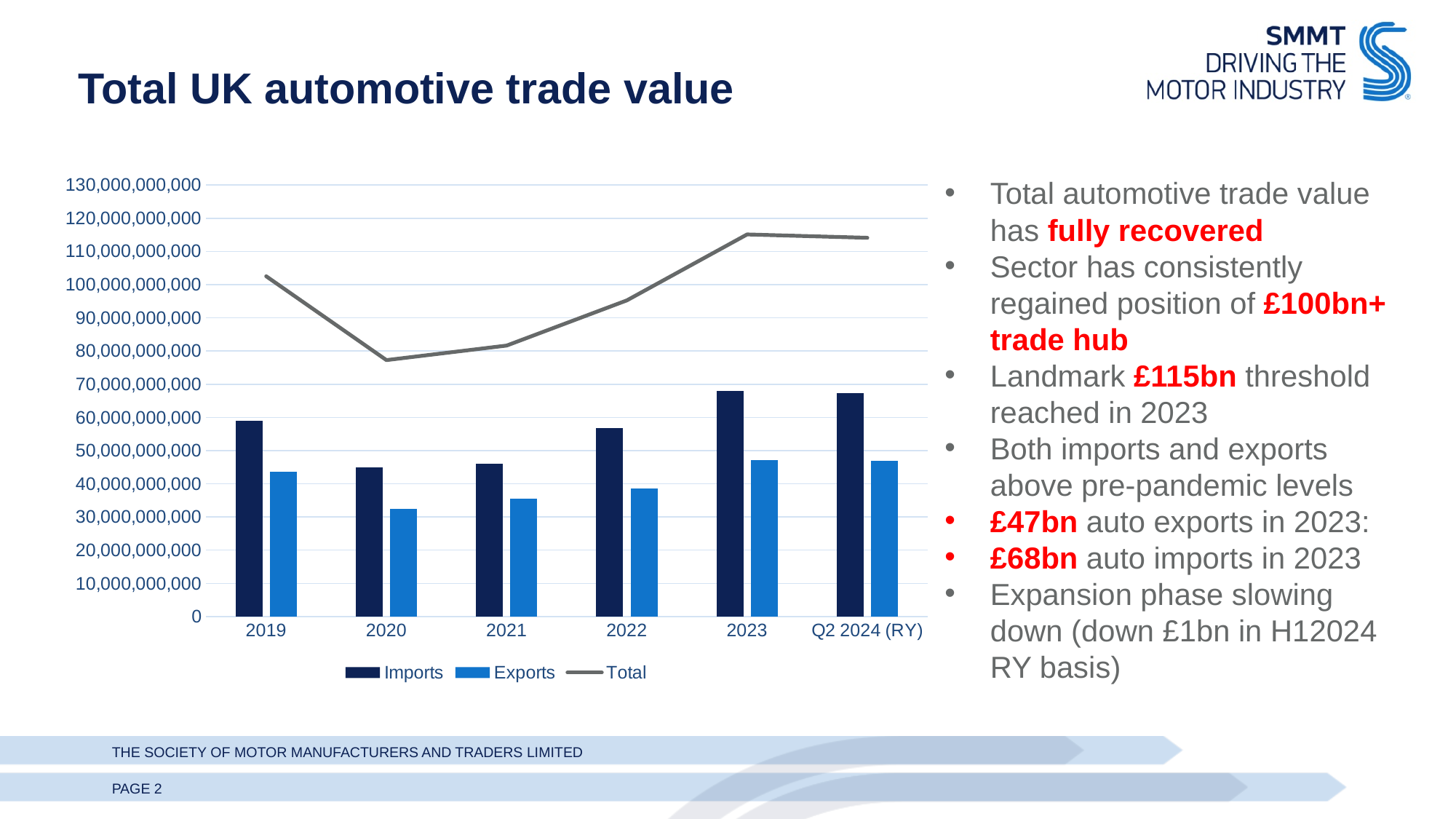
In which year is the Total value lowest? 2020 How many categories are shown on the x axis of the chart? 6 Is the Exports value for 2020 greater or less than 40,000,000,000? less Which is larger in 2019, Imports or Exports? Imports Is the Imports value for 2019 greater or less than 50,000,000,000? greater What is the title of the chart? Total UK automotive trade value Which series is drawn as a line rather than bars? Total Is the Imports value for 2023 greater or less than 60,000,000,000? greater What kind of chart is used to show Imports and Exports? Bar chart In which year is the Exports value lowest? 2020 How many series does the chart legend list? 3